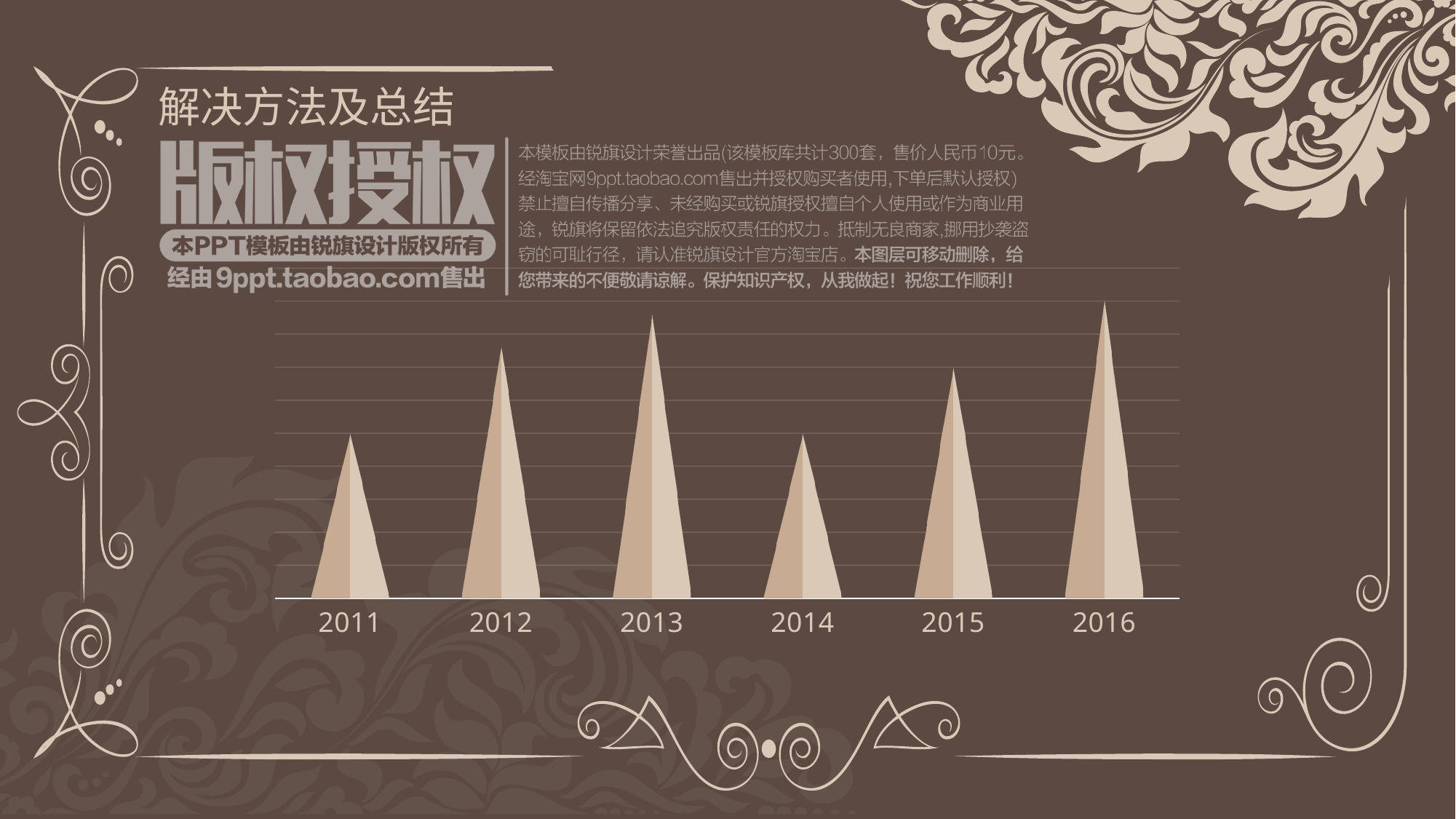
Do the values rise or fall from 2013 to 2014? fall Do the values rise or fall from 2014 to 2016? rise Which is larger, the value for 2014 or the value for 2015? 2015 Which is larger, the value for 2011 or the value for 2013? 2013 What is the first category label on the x axis of the chart? 2011 Which is larger, the value for 2013 or the value for 2015? 2013 What kind of chart is shown on the slide? bar chart Do the values rise or fall from 2011 to 2013? rise Which year has the tallest bar in the chart? 2016 How many categories are shown on the x axis of the chart? 6 What is the last category label on the x axis of the chart? 2016